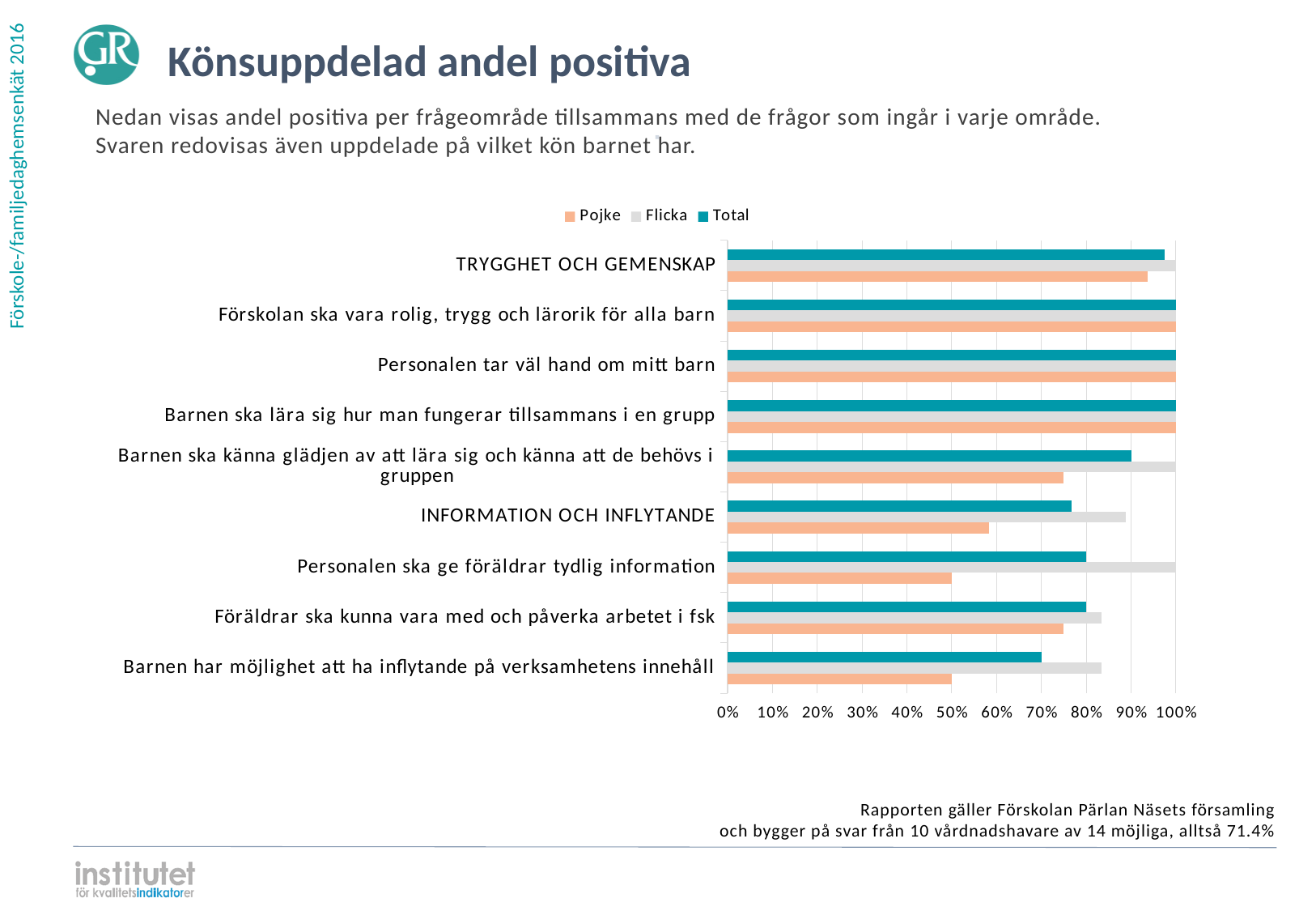
What is the Pojke value for 'Personalen ska ge föräldrar tydlig information'? 50% What is the difference between the Flicka and Pojke values for 'Personalen ska ge föräldrar tydlig information'? 50 percentage points Which category has the lowest Total value? Barnen har möjlighet att ha inflytande på verksamhetens innehåll How many series does the legend list? 3 For 'Barnen har möjlighet att ha inflytande på verksamhetens innehåll', which is larger, the Pojke value or the Flicka value? Flicka Is the Pojke value for 'INFORMATION OCH INFLYTANDE' greater or less than 50%? greater Is the Flicka value for 'TRYGGHET OCH GEMENSKAP' greater or less than 90%? greater How many categories are plotted on the y axis of the chart? 9 Which series is shown in orange in the legend? Pojke What kind of chart is shown on the slide? bar chart What is the Pojke value for 'Förskolan ska vara rolig, trygg och lärorik för alla barn'? 100% What is the Flicka value for 'Personalen ska ge föräldrar tydlig information'? 100%